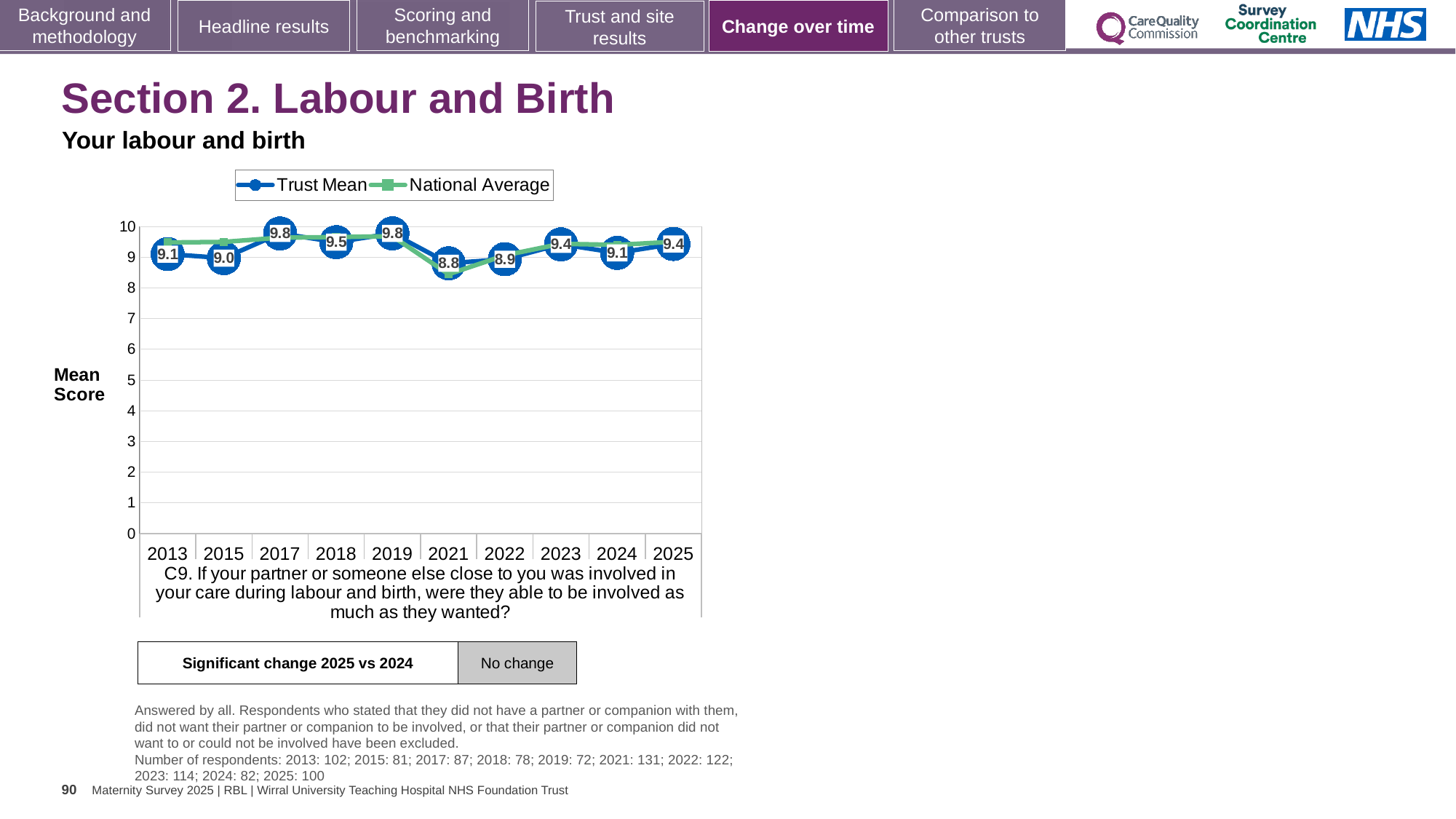
How many years are plotted on the x axis? 10 What kind of chart is shown on the slide? line chart Is the National Average value for 2021 greater or less than 9? less What is the highest Trust Mean value shown on the chart? 9.8 What is the Trust Mean value for 2021? 8.8 In which year is the Trust Mean lowest? 2021 What is the Trust Mean value for 2018? 9.5 Which year has the larger Trust Mean, 2017 or 2013? 2017 Does the Trust Mean rise or fall from 2019 to 2021? fall How many series does the legend list? 2 What is the Trust Mean value for 2025? 9.4 What is the difference between the Trust Mean in 2025 and in 2024? 0.3